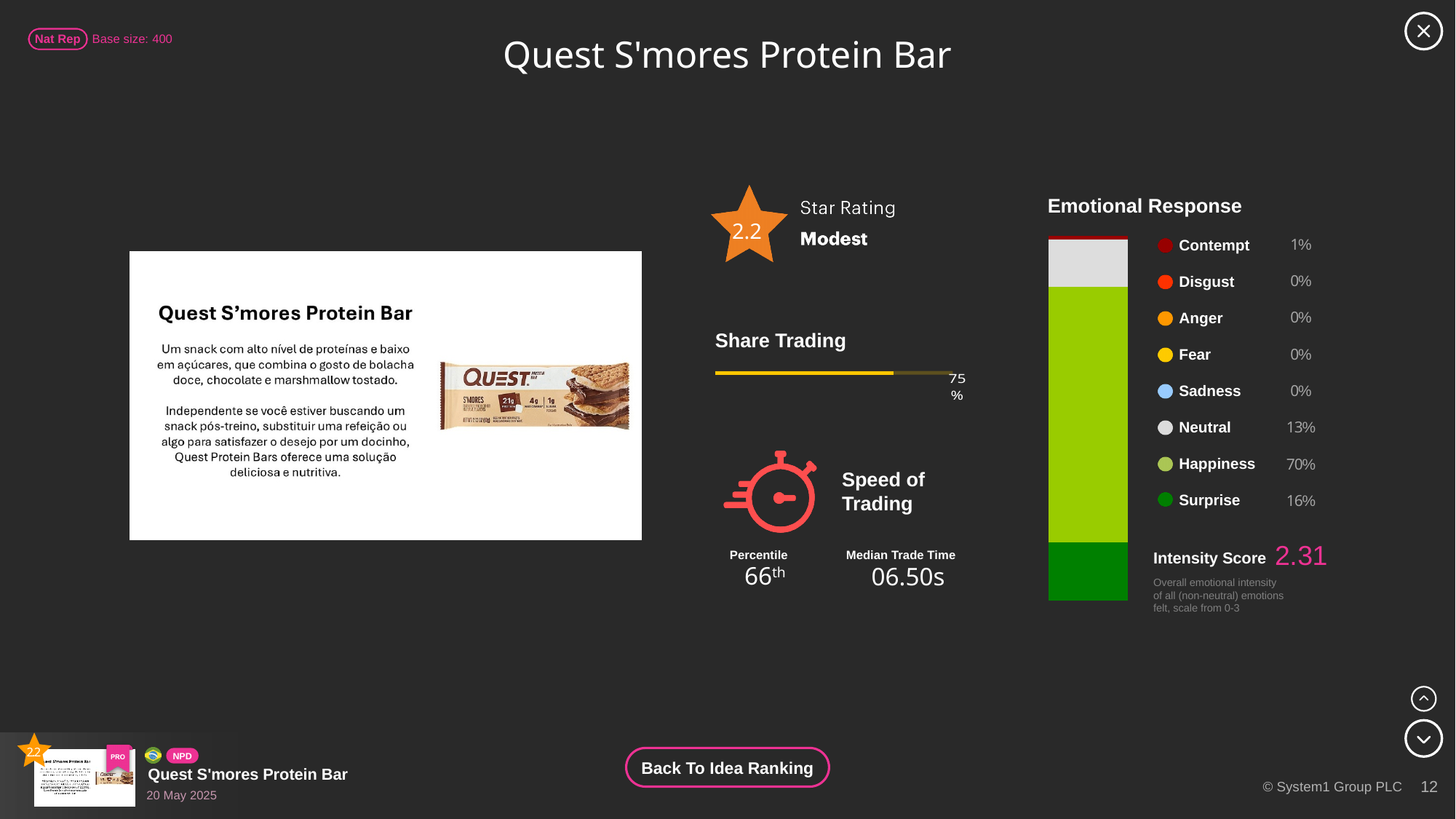
In the Emotional Response chart, which emotion has the highest percentage? Happiness What value is shown on the Share Trading bar? 75% In the Emotional Response chart, which is larger, Neutral or Surprise? Surprise In the Emotional Response chart, what is the difference between the Happiness and Surprise percentages? 54% What kind of chart is used for the Emotional Response? Stacked bar chart In the Emotional Response chart, what percentage is shown for Neutral? 13% What Intensity Score is shown next to the Emotional Response chart? 2.31 In the Emotional Response chart, what percentage is shown for Contempt? 1% In the Emotional Response chart, how many emotions are shown at 0%? 4 In the Emotional Response chart, how many emotions are listed in the legend? 8 In the Emotional Response chart, what percentage is shown for Surprise? 16% In the Emotional Response chart, what percentage is shown for Happiness? 70%